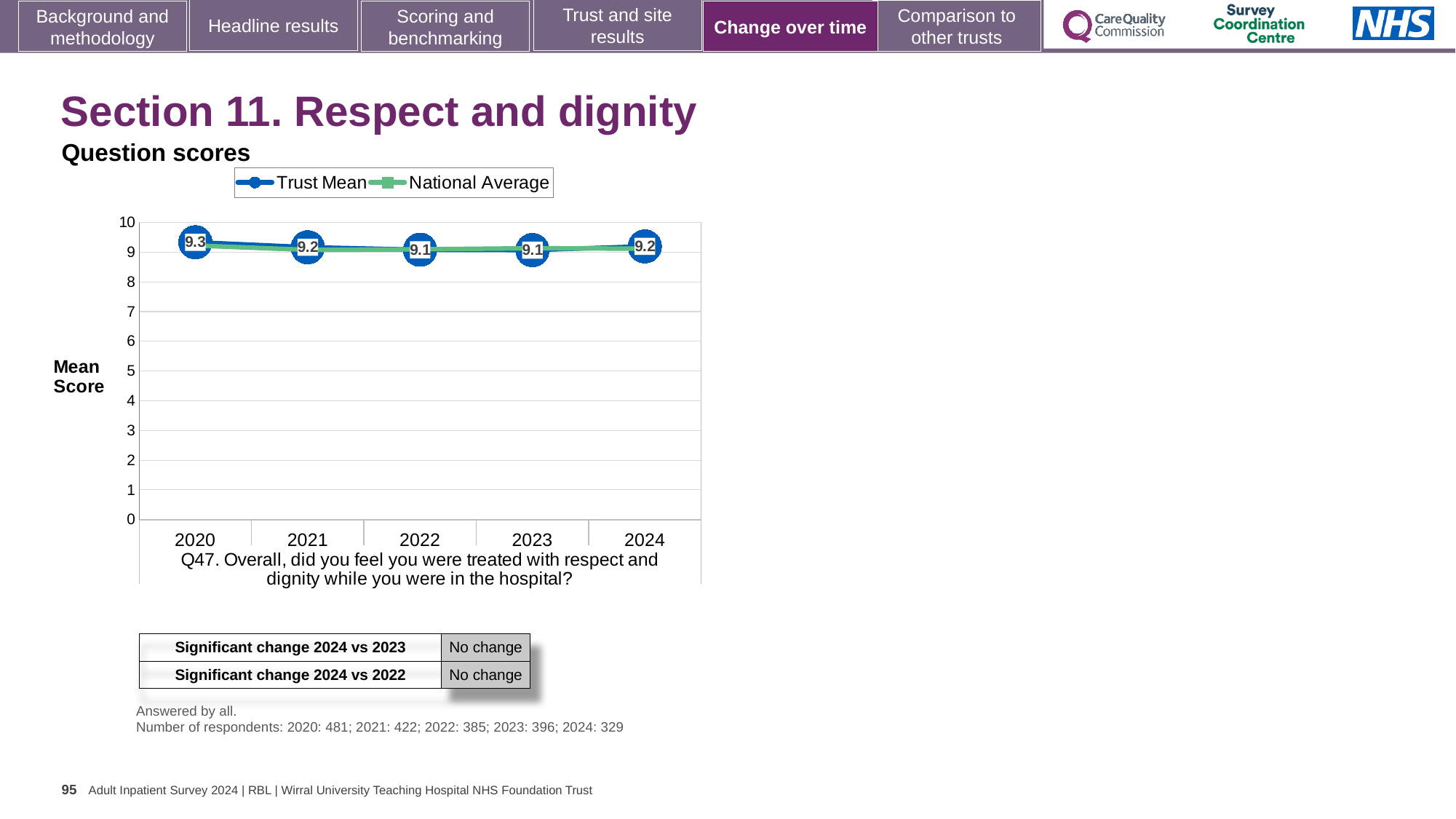
Which is larger, the Trust Mean score for 2020 or for 2023? 2020 What is the difference between the Trust Mean scores for 2020 and 2022? 0.2 What is the Trust Mean score for 2024? 9.2 What are the two series named in the legend? Trust Mean and National Average What kind of chart is shown on the slide? Line chart Is the National Average value for 2024 greater or less than 8? greater In which year is the Trust Mean score highest? 2020 Does the Trust Mean score rise or fall from 2020 to 2022? Fall What is the Trust Mean score for 2020? 9.3 How many series does the legend list? 2 What is the Trust Mean score for 2022? 9.1 How many years are plotted on the x axis? 5